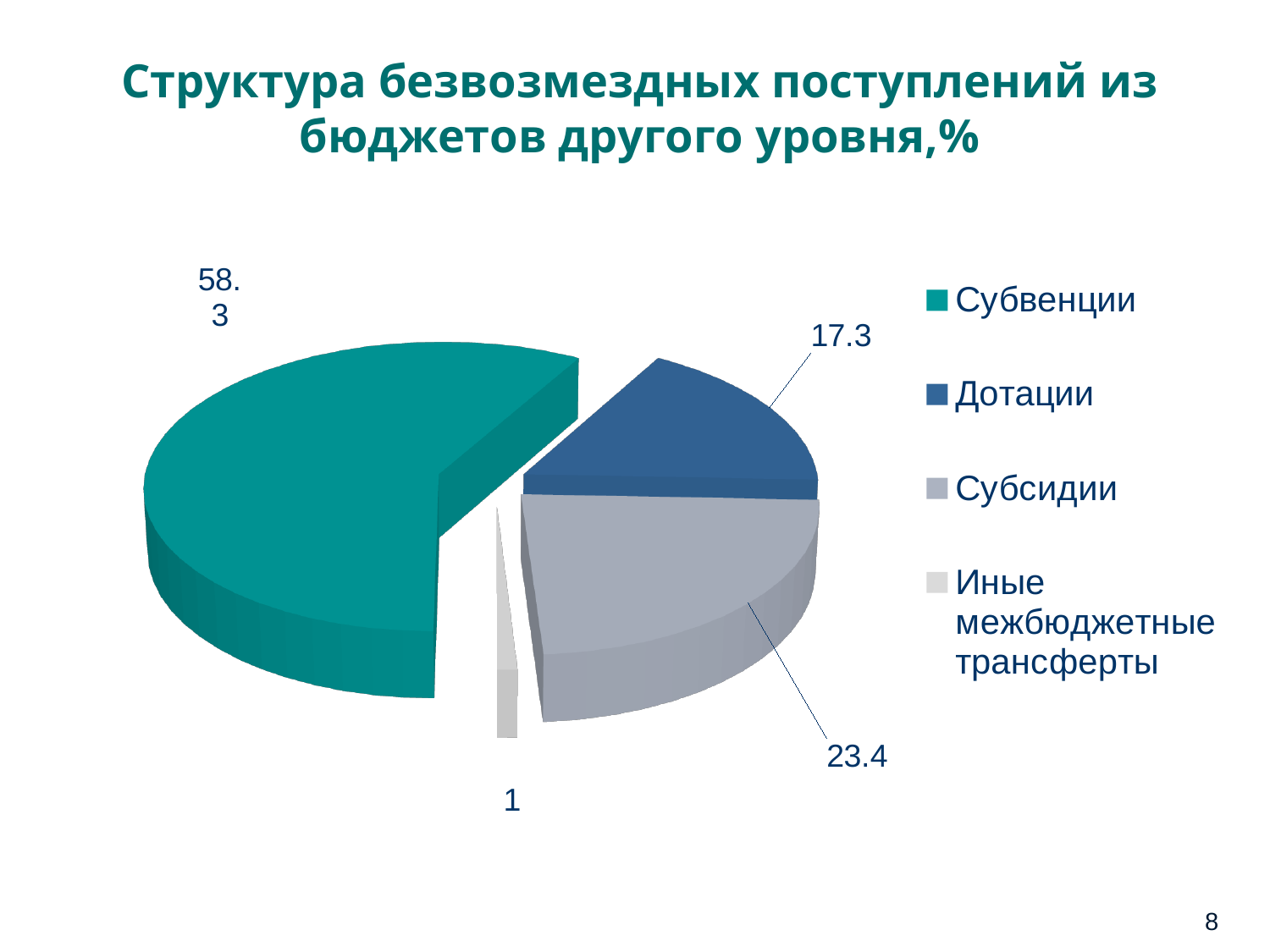
What is the value for Субсидии? 23.4 What is the value for Субвенции? 58.3 Which category has the smallest share of the pie? Иные межбюджетные трансферты How many categories does the pie chart have? 4 What type of chart is shown on the slide? pie chart Which category has the largest share of the pie? Субвенции What is the difference between the values for Субсидии and Дотации? 6.1 Which is larger, the value for Субсидии or the value for Дотации? Субсидии What is the value for Иные межбюджетные трансферты? 1 What colour is the slice for Субвенции? teal What is the value for Дотации? 17.3 What is the title of the chart on the slide? Структура безвозмездных поступлений из бюджетов другого уровня,%